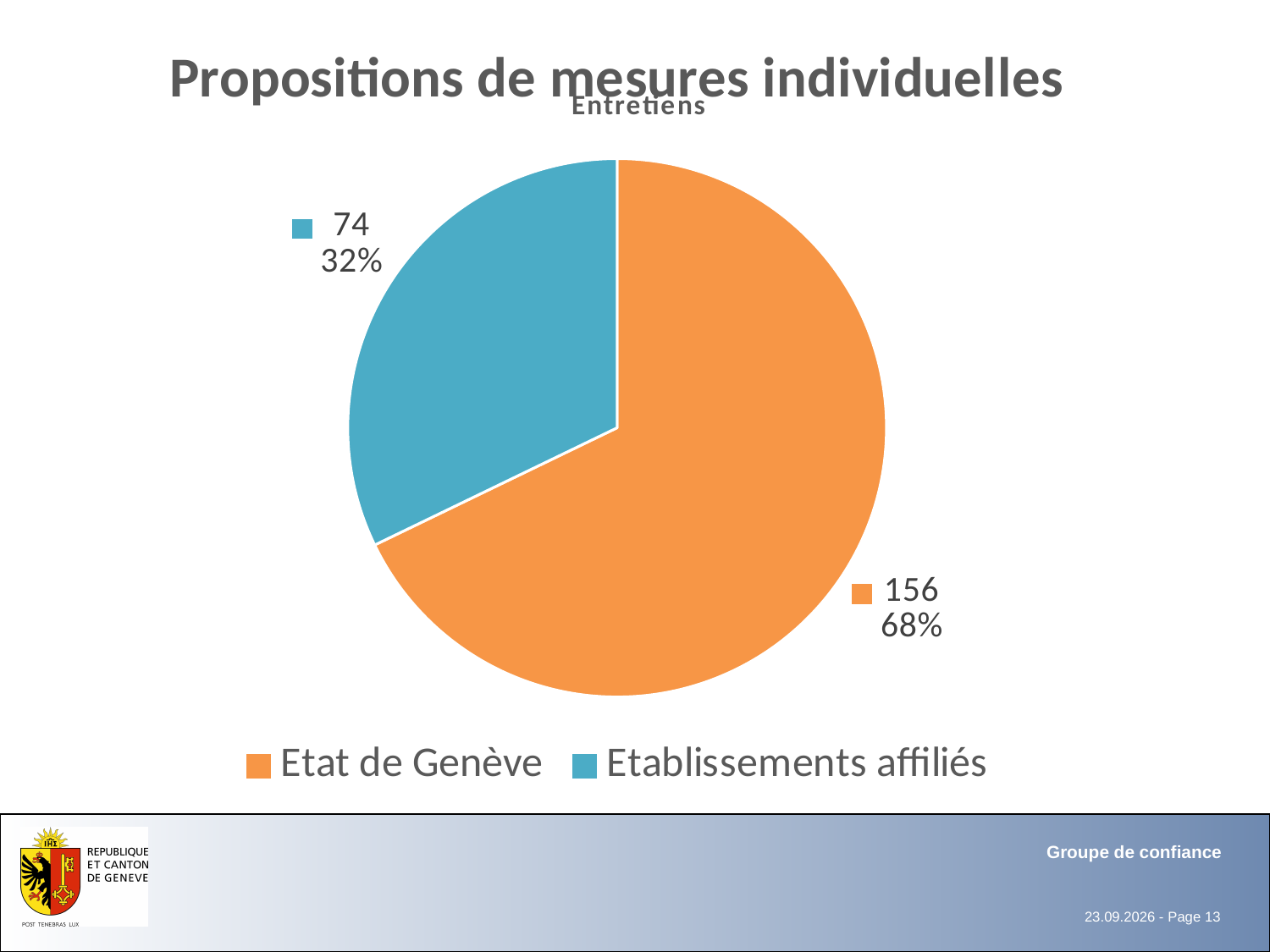
What share of the pie does Etat de Genève represent? 68% Which category has the largest slice? Etat de Genève What is the total of the two slices in the pie chart? 230 What is the value for Etat de Genève? 156 What is the difference between the values for Etat de Genève and Etablissements affiliés? 82 What is the value for Etablissements affiliés? 74 What kind of chart is shown on the slide? pie chart How many slices does the pie chart have? 2 What share of the pie does Etablissements affiliés represent? 32% Which category has the smallest slice? Etablissements affiliés Which is larger, the value for Etat de Genève or for Etablissements affiliés? Etat de Genève